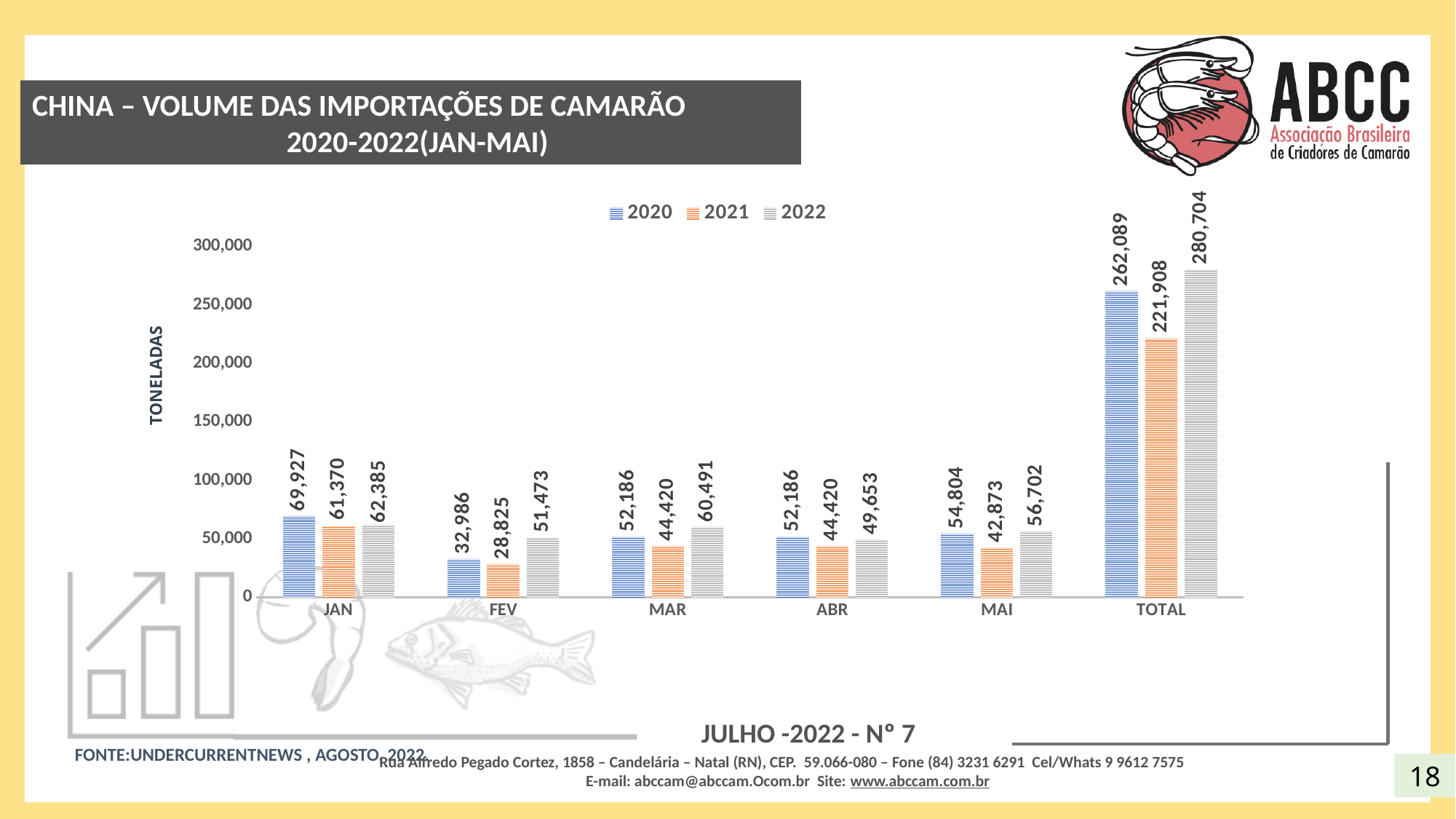
What is the label of the vertical axis? TONELADAS What is the TOTAL value for 2020? 262,089 Which year has the highest TOTAL value? 2022 How many categories are shown on the x axis? 6 Which month (excluding TOTAL) has the lowest value for 2020? FEV Which is larger in MAI, the value for 2020 or the value for 2022? 2022 What is the value for 2022 in JAN? 62,385 How many series does the legend list? 3 Is the TOTAL value for 2021 greater or less than 250,000? less What is the value for 2021 in FEV? 28,825 What type of chart is shown on the slide? bar chart What is the difference between the 2022 and 2021 values in MAR? 16,071